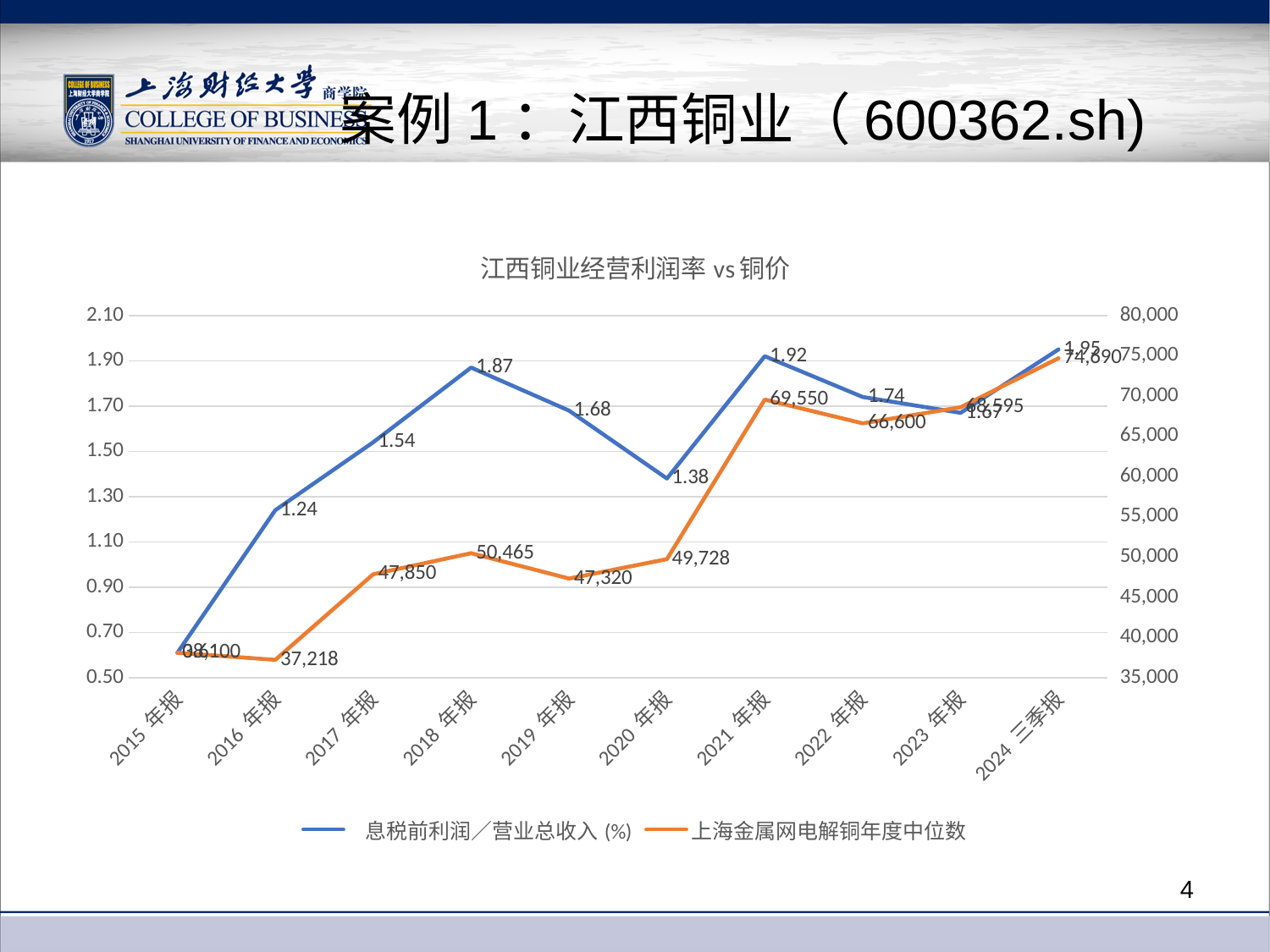
Which is larger for 上海金属网电解铜年度中位数: 2018 年报 or 2019 年报? 2018 年报 What kind of chart is shown on the slide? line chart Does 息税前利润／营业总收入 (%) rise or fall from 2018 年报 to 2020 年报? fall What is the title of the chart? 江西铜业经营利润率 vs 铜价 What is the value of 上海金属网电解铜年度中位数 for 2021 年报? 69,550 What is the value of 息税前利润／营业总收入 (%) for 2018 年报? 1.87 What is the difference in 息税前利润／营业总收入 (%) between 2021 年报 and 2020 年报? 0.54 Which period has the highest value of 息税前利润／营业总收入 (%)? 2024 三季报 Which period has the lowest value of 上海金属网电解铜年度中位数? 2016 年报 What is the value of 息税前利润／营业总收入 (%) for 2022 年报? 1.74 How many series does the legend list? 2 How many reporting periods are shown on the x axis? 10